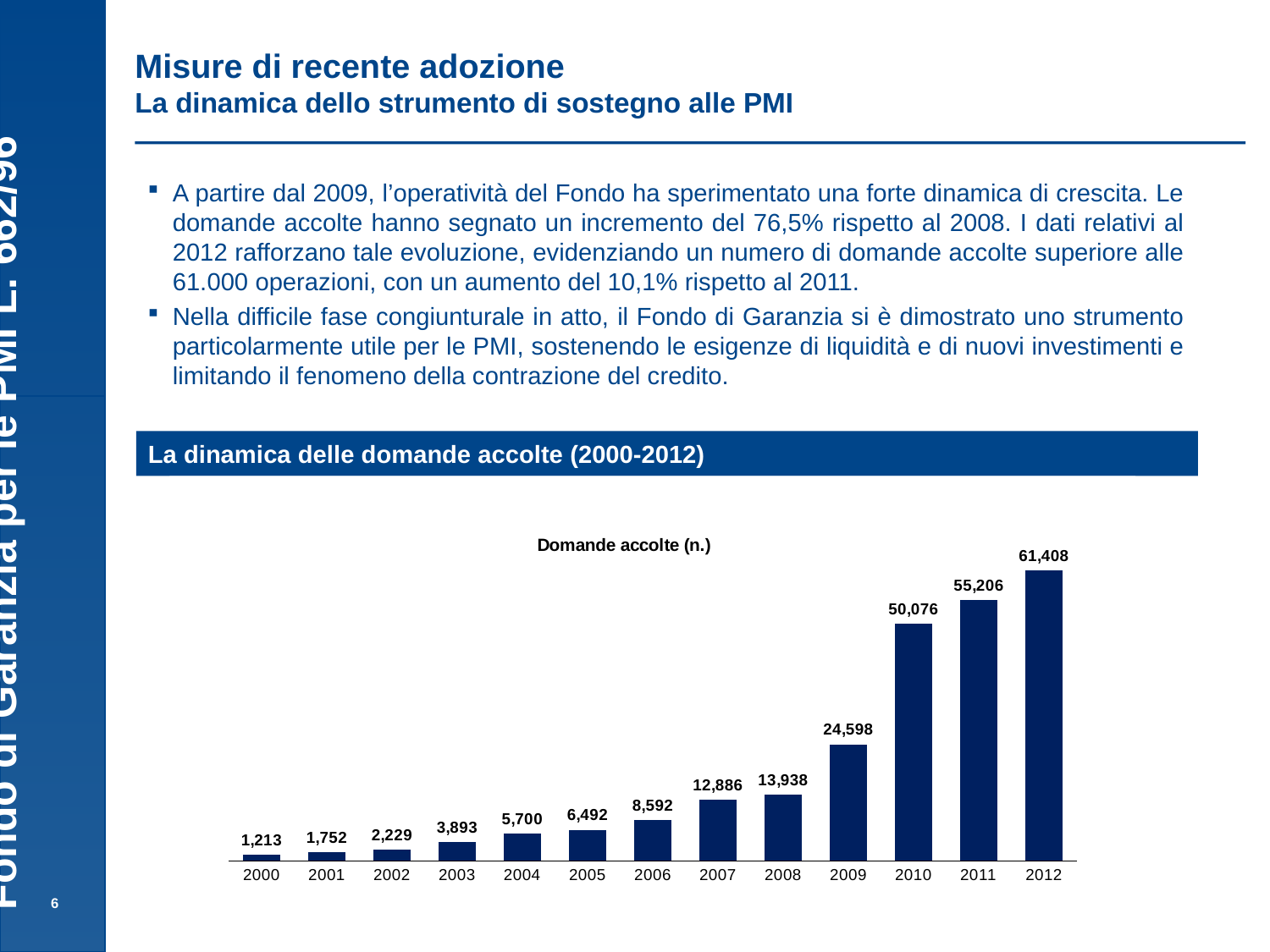
What type of chart is shown on the slide? Bar chart Which year has the highest number of domande accolte? 2012 Which year has the lowest number of domande accolte? 2000 Do the values rise or fall from 2000 to 2012? Rise What is the difference between the domande accolte in 2012 and in 2011? 6,202 How many years are shown on the x axis of the chart? 13 What is the difference between the domande accolte in 2010 and in 2009? 25,478 What is the number of domande accolte in 2009? 24,598 Which year has more domande accolte, 2007 or 2008? 2008 What is the number of domande accolte in 2012? 61,408 What is the number of domande accolte in 2005? 6,492 What is the number of domande accolte in 2000? 1,213